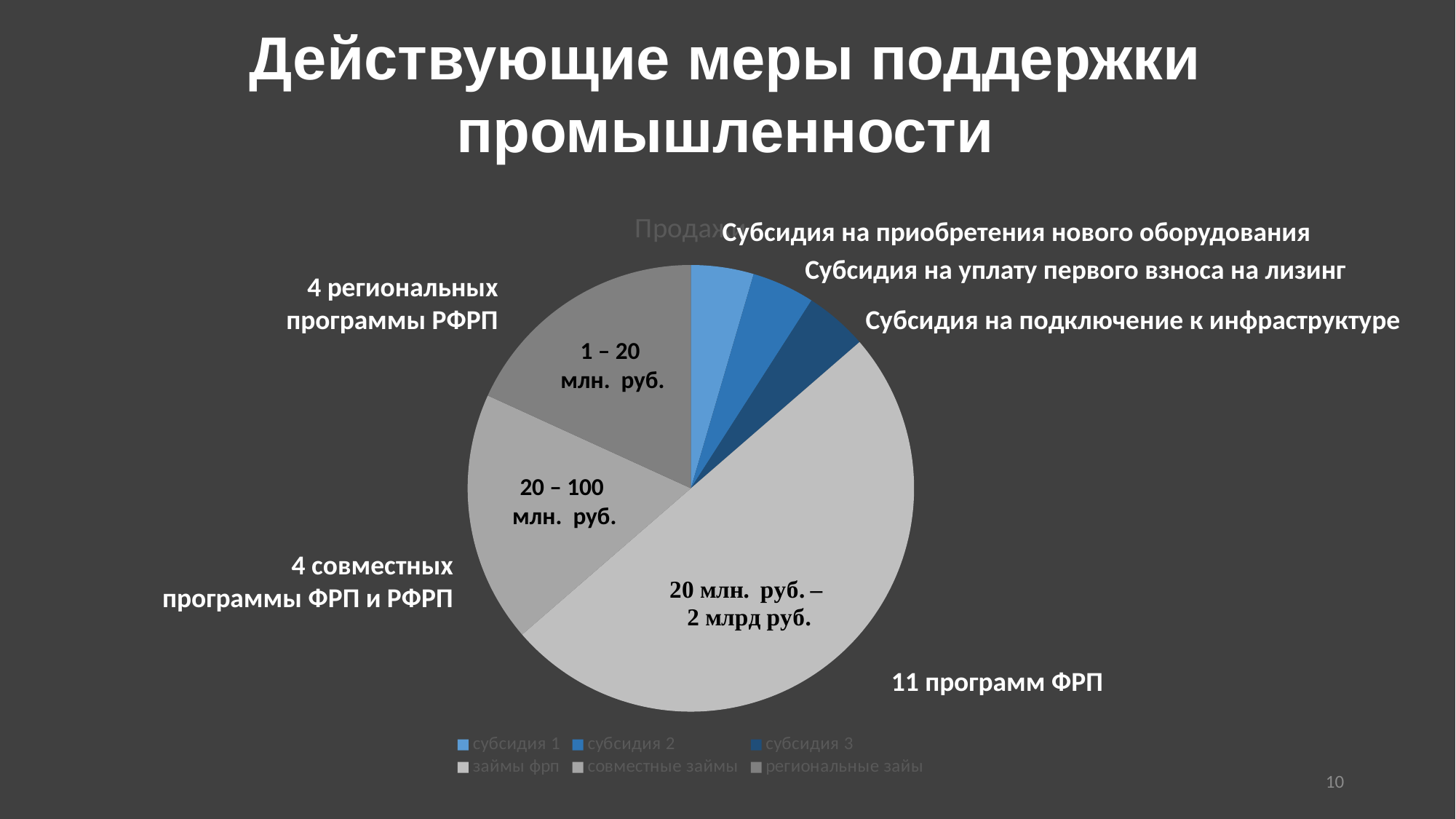
Which is larger in the pie chart: совместные займы or субсидия 3? совместные займы Which slice of the pie chart is the largest? займы фрп What is the title of the pie chart? Продажи How many slices does the pie chart have? 6 Which is larger in the pie chart: займы фрп or совместные займы? займы фрп Which is larger in the pie chart: региональные зайы or субсидия 1? региональные зайы What is the first entry listed in the legend of the pie chart? субсидия 1 What kind of chart is shown on the slide? pie chart How many entries does the legend of the pie chart list? 6